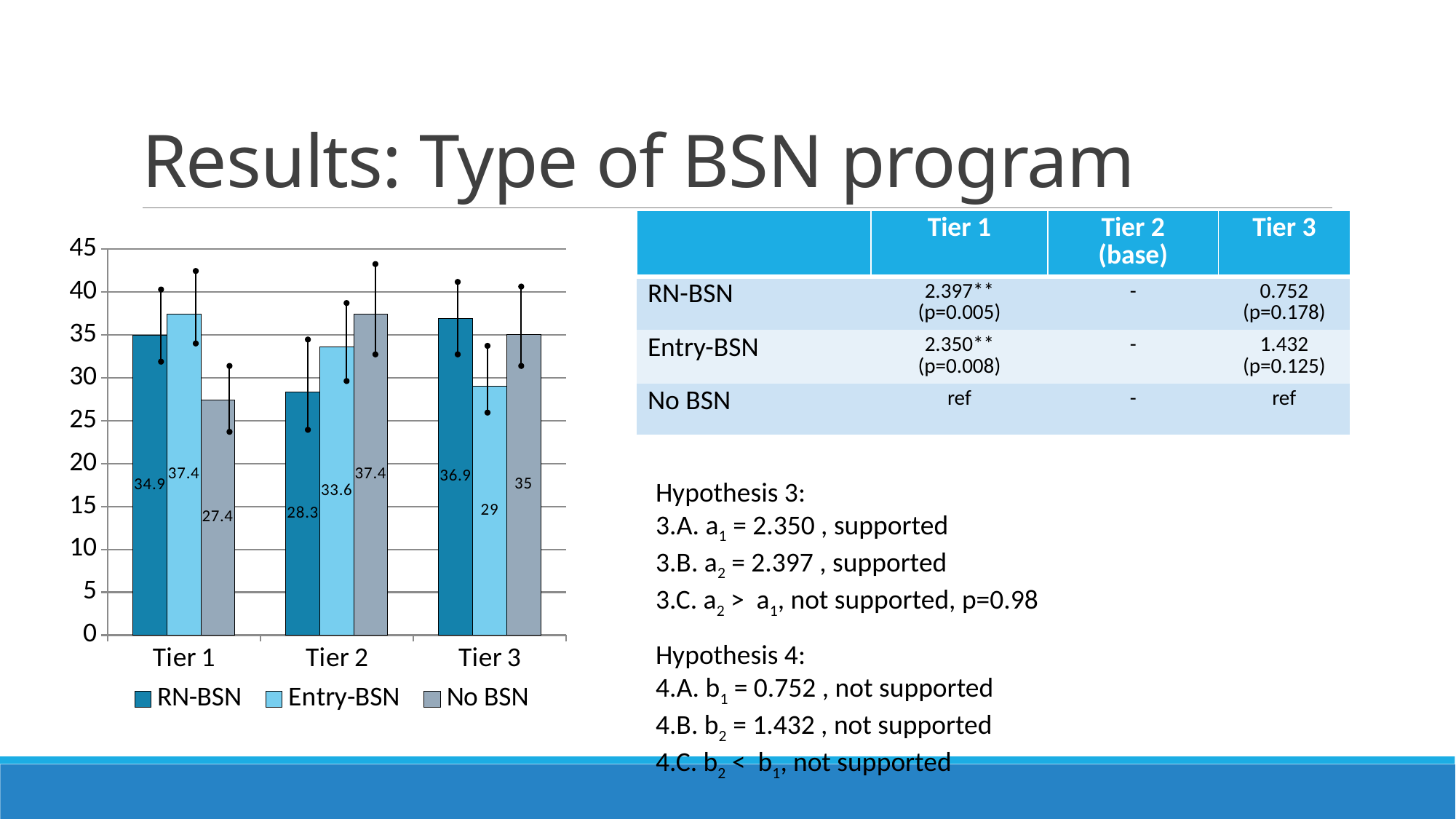
Which category has the highest value for RN-BSN? Tier 3 What is the value for RN-BSN in Tier 1? 34.9 What is the value for Entry-BSN in Tier 3? 29 Is the value for No BSN in Tier 1 greater or less than 30? less How many categories are shown on the x axis? 3 Which category has the lowest value for No BSN? Tier 1 What is the difference between the Entry-BSN value and the No BSN value in Tier 1? 10 What is the value for No BSN in Tier 2? 37.4 How many series does the legend list? 3 Which is larger in Tier 2: RN-BSN or Entry-BSN? Entry-BSN Which series is shown in the darkest blue colour? RN-BSN What kind of chart is shown on the slide? bar chart